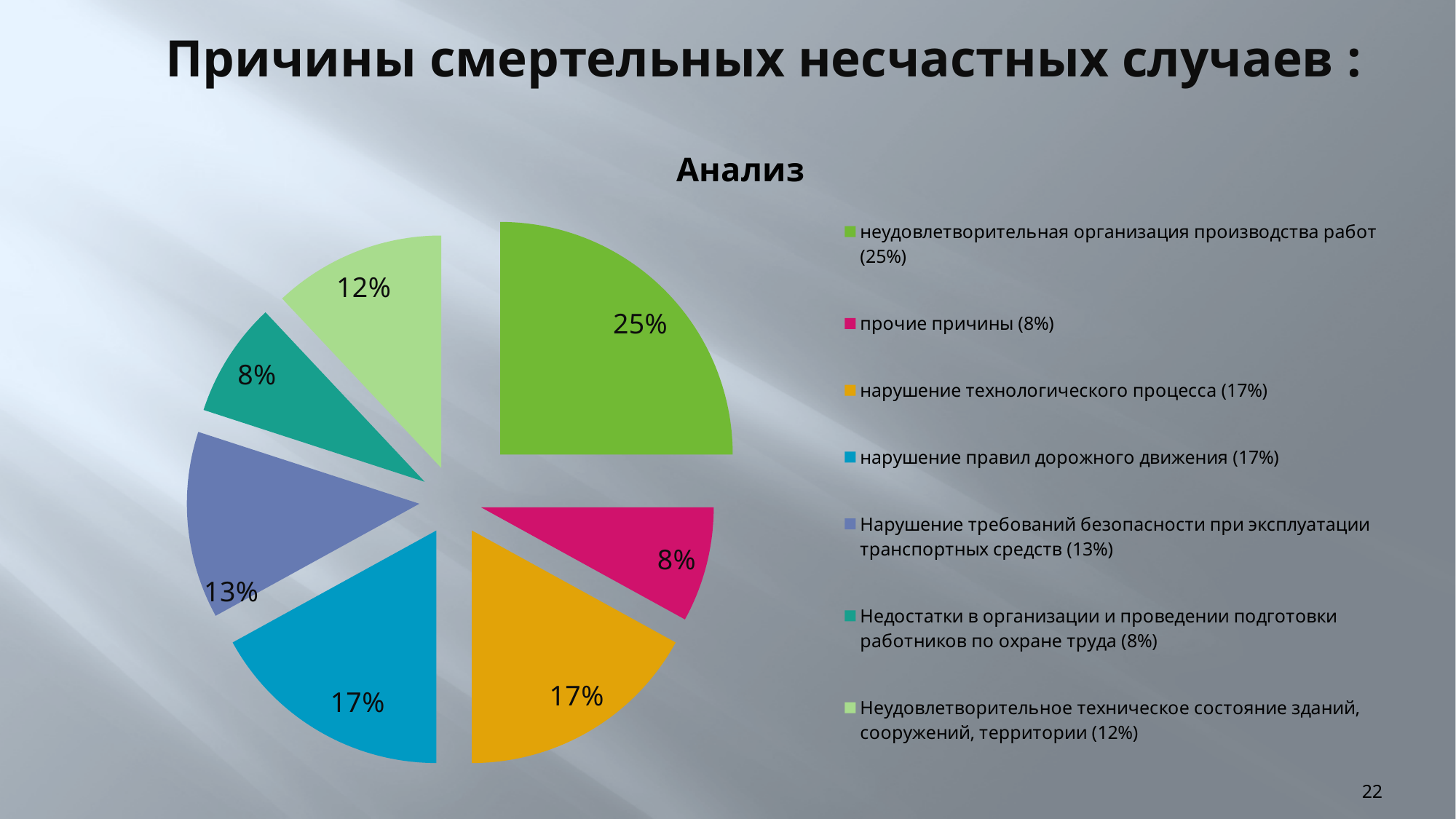
What is the value for 'нарушение технологического процесса'? 17% What is the value for 'Недостатки в организации и проведении подготовки работников по охране труда'? 8% What is the difference between the share for 'неудовлетворительная организация производства работ' and the share for 'прочие причины'? 17% How many slices does the pie chart have? 7 What is the chart's title? Анализ What is the value for 'Нарушение требований безопасности при эксплуатации транспортных средств'? 13% What share of the pie is 'неудовлетворительная организация производства работ'? 25% Which is larger: the share for 'нарушение правил дорожного движения' or the share for 'Нарушение требований безопасности при эксплуатации транспортных средств'? нарушение правил дорожного движения What is the value for 'Неудовлетворительное техническое состояние зданий, сооружений, территории'? 12% What kind of chart is shown on the slide? pie chart What colour is the slice for 'прочие причины'? pink Which category has the largest share of the pie? неудовлетворительная организация производства работ